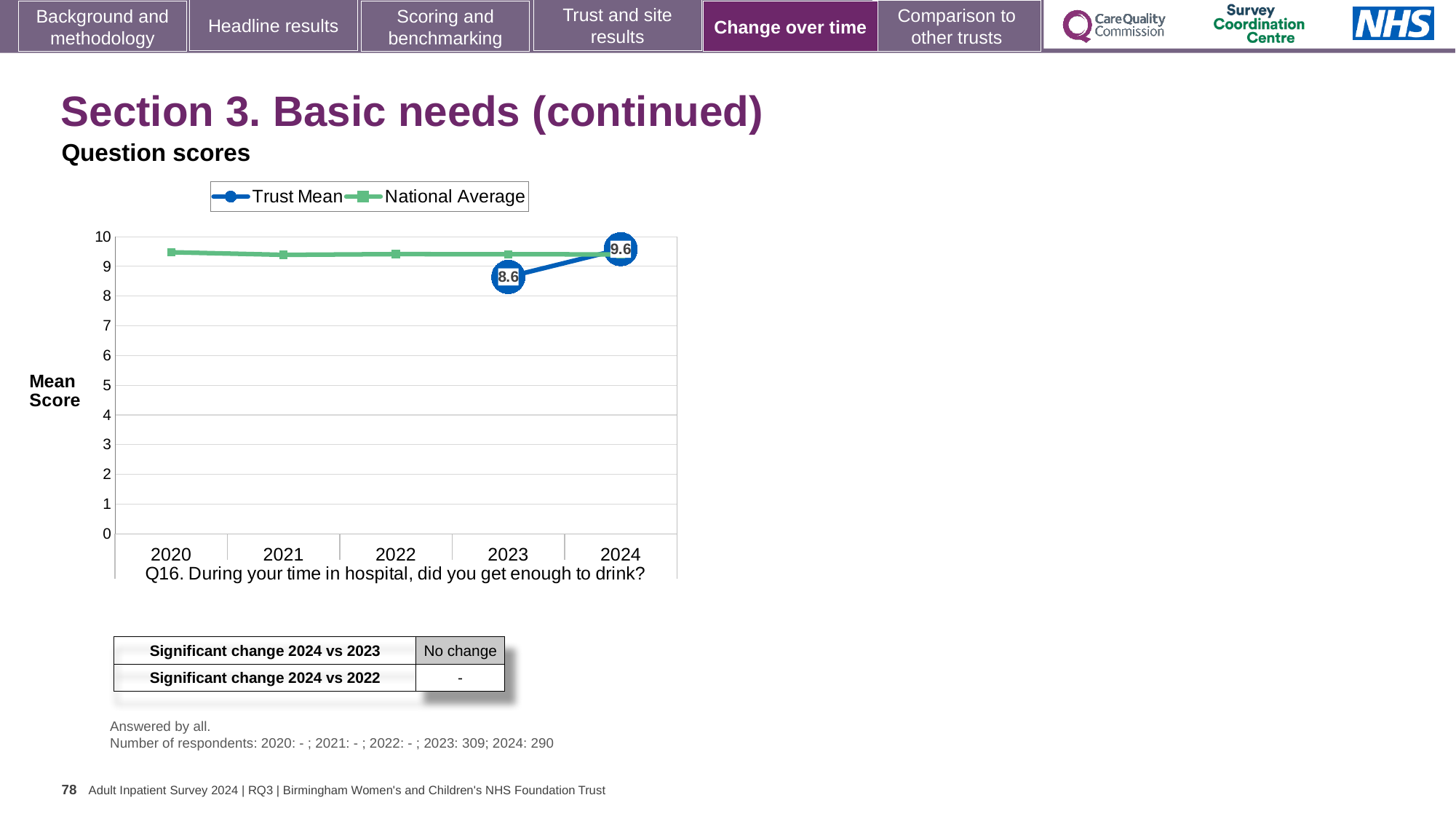
What is the Trust Mean value for 2023? 8.6 Does the Trust Mean rise or fall from 2023 to 2024? Rise What is the Trust Mean value for 2024? 9.6 What survey question is the chart about, as labelled below the x axis? Q16. During your time in hospital, did you get enough to drink? In 2023, which is higher: the Trust Mean or the National Average? National Average Is the National Average value for 2020 greater or less than 9? greater What kind of chart is shown on the slide? Line chart How many series does the chart legend list? 2 By how much did the Trust Mean change from 2023 to 2024? 1.0 Is the Trust Mean value for 2023 greater or less than 9? less Which year has the higher Trust Mean, 2023 or 2024? 2024 How many years are shown on the x axis of the chart? 5